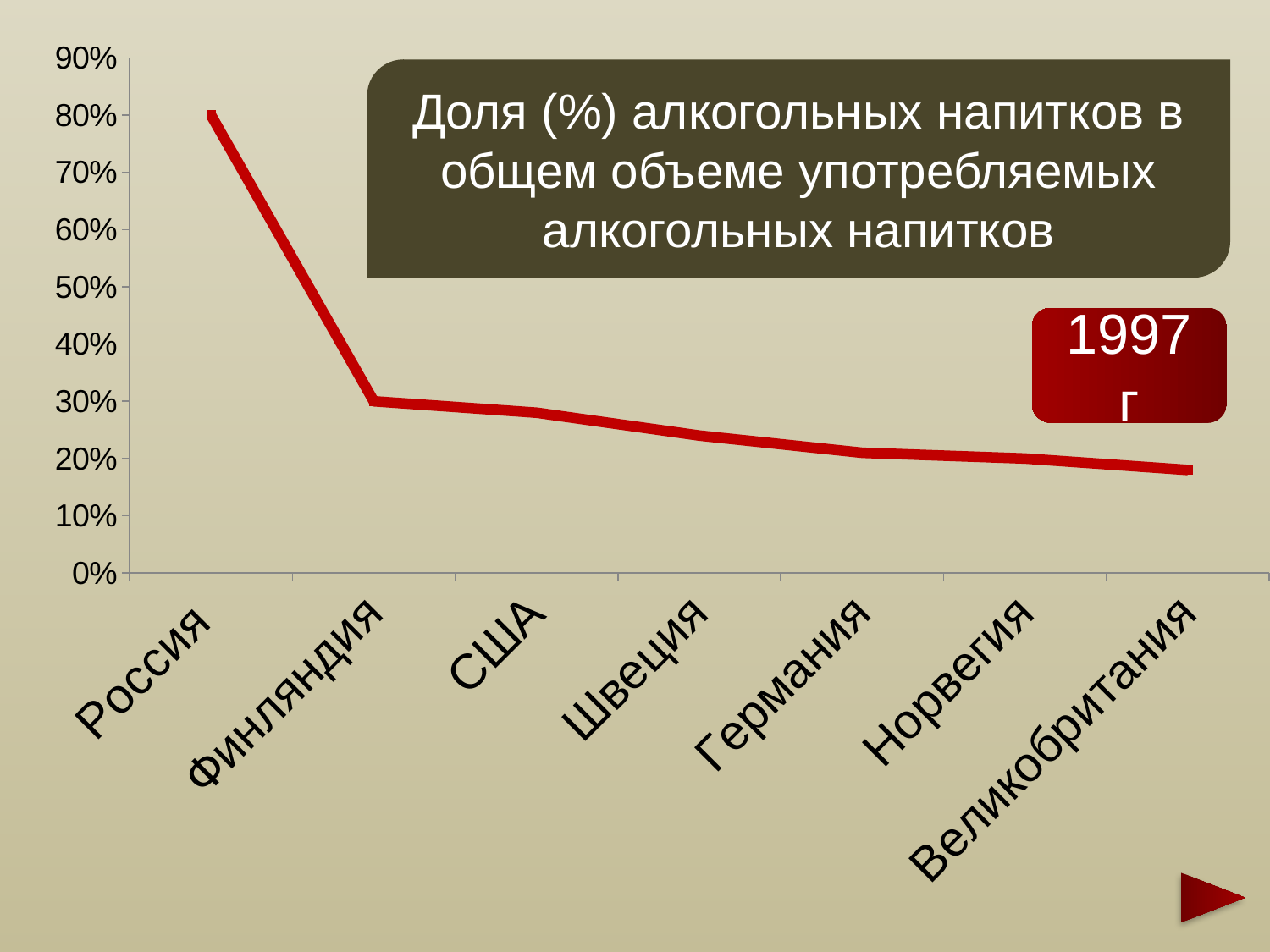
Which country has the highest value on the chart? Россия Which year is shown in the red box on the slide? 1997 г How many countries are plotted along the x axis? 7 Which is larger, the value for Финляндия or the value for Швеция? Финляндия Is the value for Великобритания greater or less than 20%? less What kind of chart is shown on the slide? line chart Is the value for Россия greater or less than 70%? greater Is the value for Финляндия greater or less than 50%? less Do the values rise or fall moving from Россия to Великобритания along the x axis? fall Which country has the lowest value on the chart? Великобритания What is the value for Россия? 80%